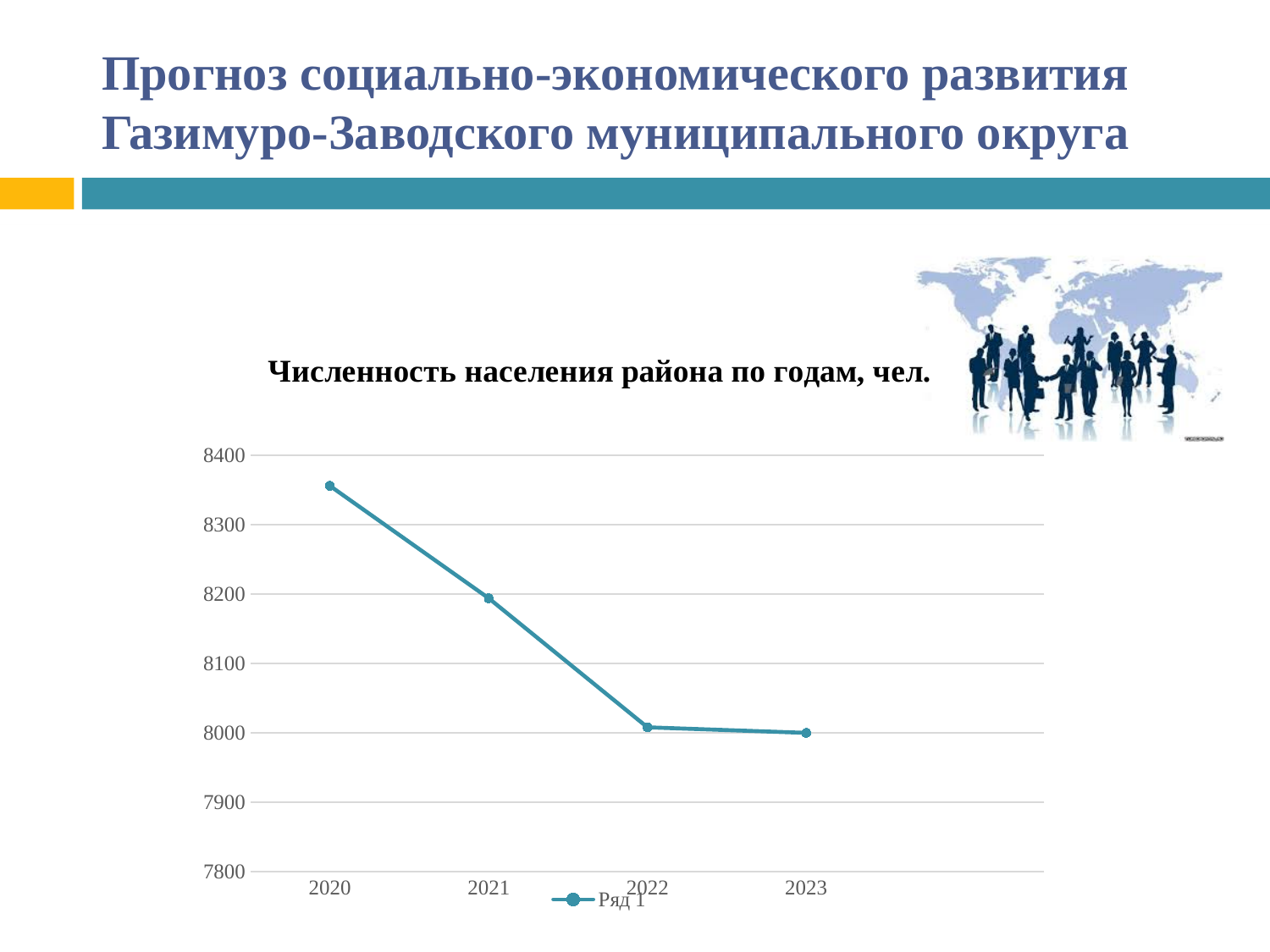
What kind of chart is shown on the slide? line chart Which is larger, the value for 2020 or the value for 2022? 2020 Do the values rise or fall from 2020 to 2023? fall How many years (data points) are plotted on the chart? 4 Is the value for 2023 greater or less than 8200? less Is the value for 2020 greater or less than 8300? greater What is the title of the chart? Численность населения района по годам, чел. How many series does the legend list? 1 Which year has the highest population value on the chart? 2020 What is the name of the series shown in the legend? Ряд 1 Is the value for 2022 greater or less than 8100? less